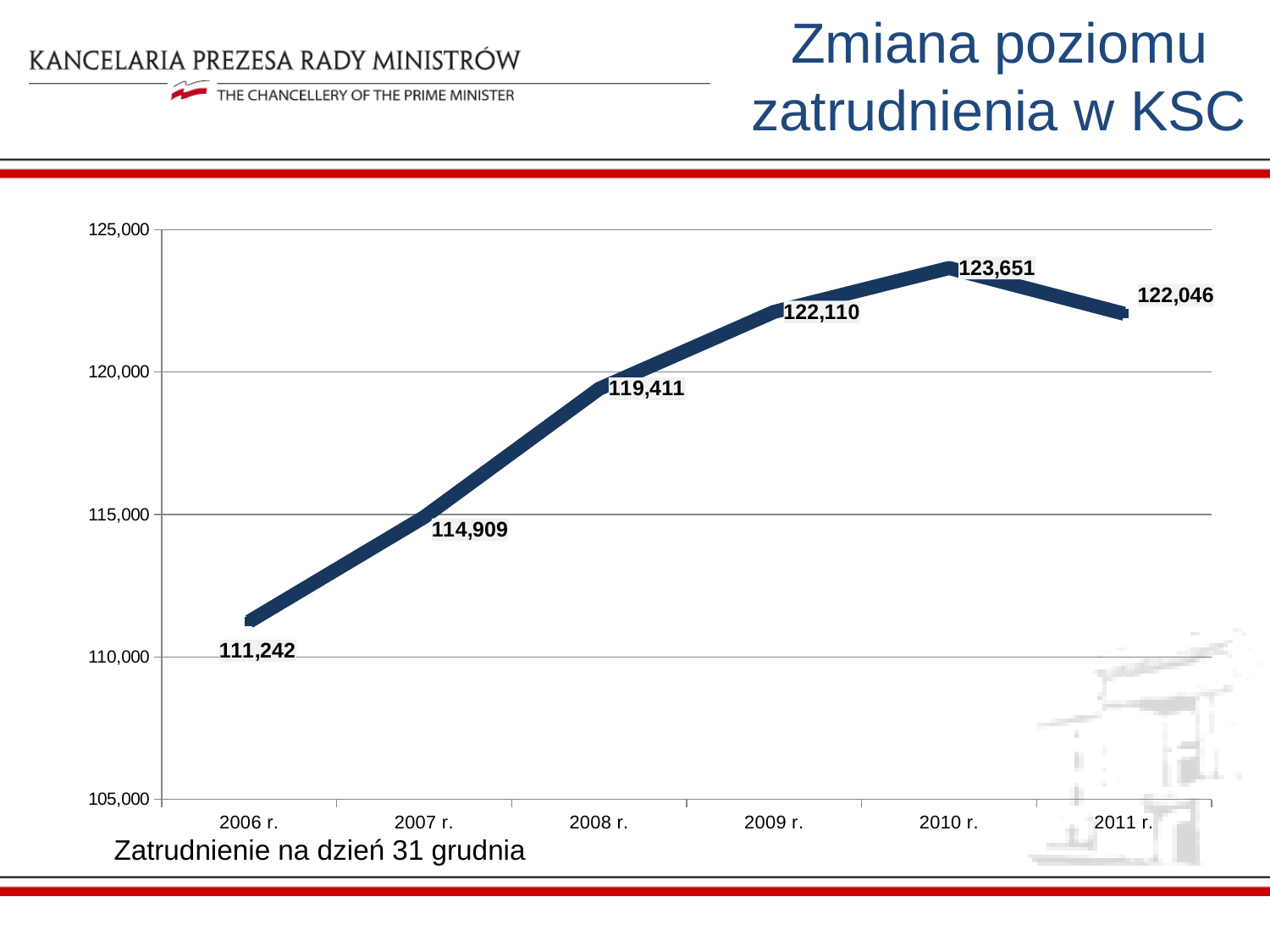
What is the employment value shown for 2009 r.? 122,110 Which year has the lowest employment value on the chart? 2006 r. Is the value for 2008 r. greater or less than 120,000? less What is the difference between the values for 2007 r. and 2006 r.? 3,667 Which is larger, the value for 2008 r. or the value for 2009 r.? 2009 r. Which year has the highest employment value on the chart? 2010 r. What kind of chart is shown on the slide? line chart What is the difference between the values for 2010 r. and 2011 r.? 1,605 What is the employment value shown for 2006 r.? 111,242 How many years are plotted on the x axis? 6 Does the line rise or fall between 2006 r. and 2010 r.? rise What is the employment value shown for 2011 r.? 122,046